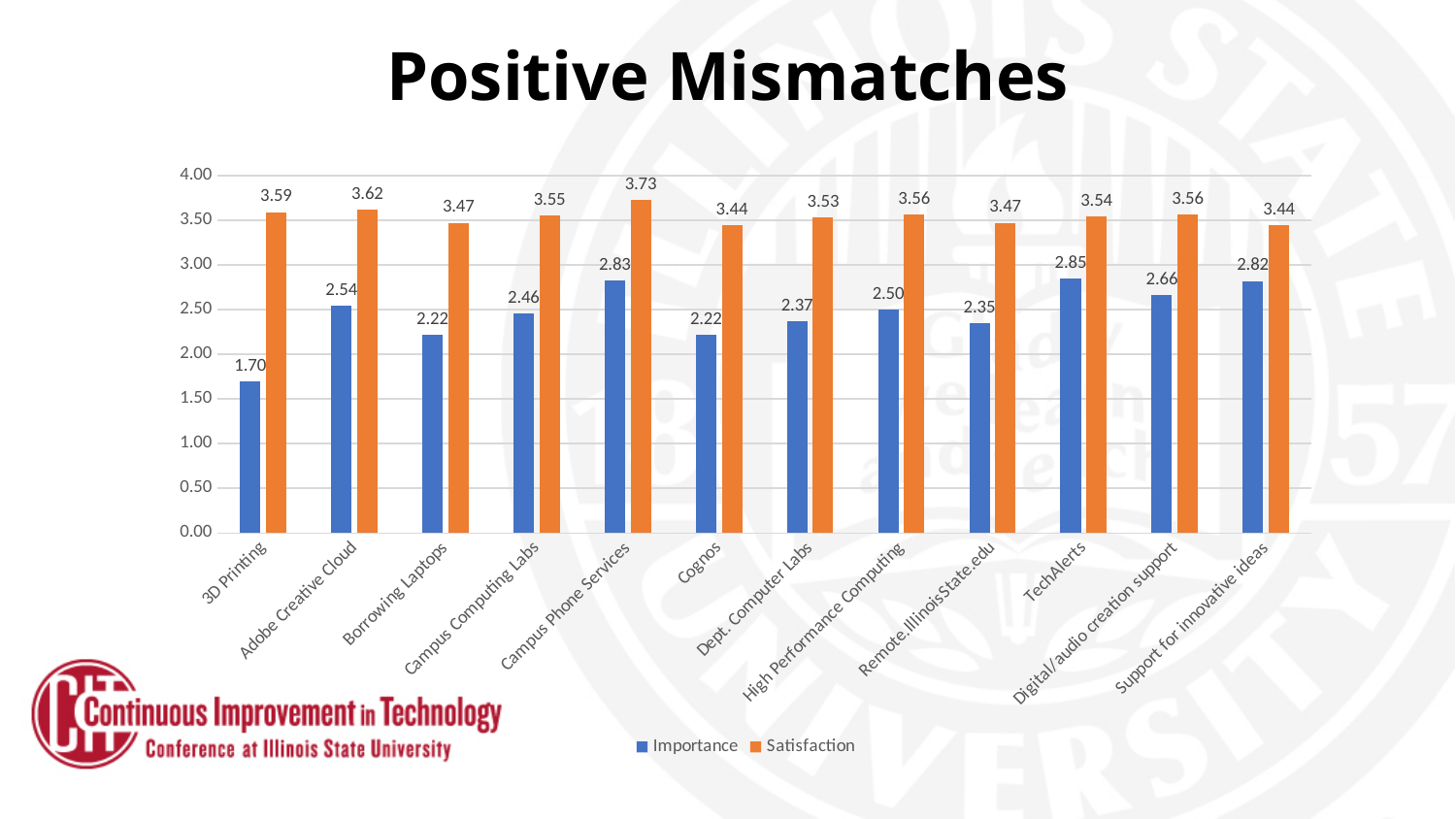
How many categories are shown on the x axis? 12 What is the title of the chart? Positive Mismatches Which category has the highest Satisfaction value? Campus Phone Services What is the Satisfaction value for Borrowing Laptops? 3.47 What kind of chart is shown on the slide? Bar chart What is the Importance value for TechAlerts? 2.85 What is the difference between the Satisfaction and Importance values for 3D Printing? 1.89 What is the Importance value for 3D Printing? 1.70 How many series does the legend list? 2 What is the Satisfaction value for Campus Phone Services? 3.73 Which category has the lowest Importance value? 3D Printing Which is larger, the Importance value for Adobe Creative Cloud or the Importance value for Cognos? Adobe Creative Cloud